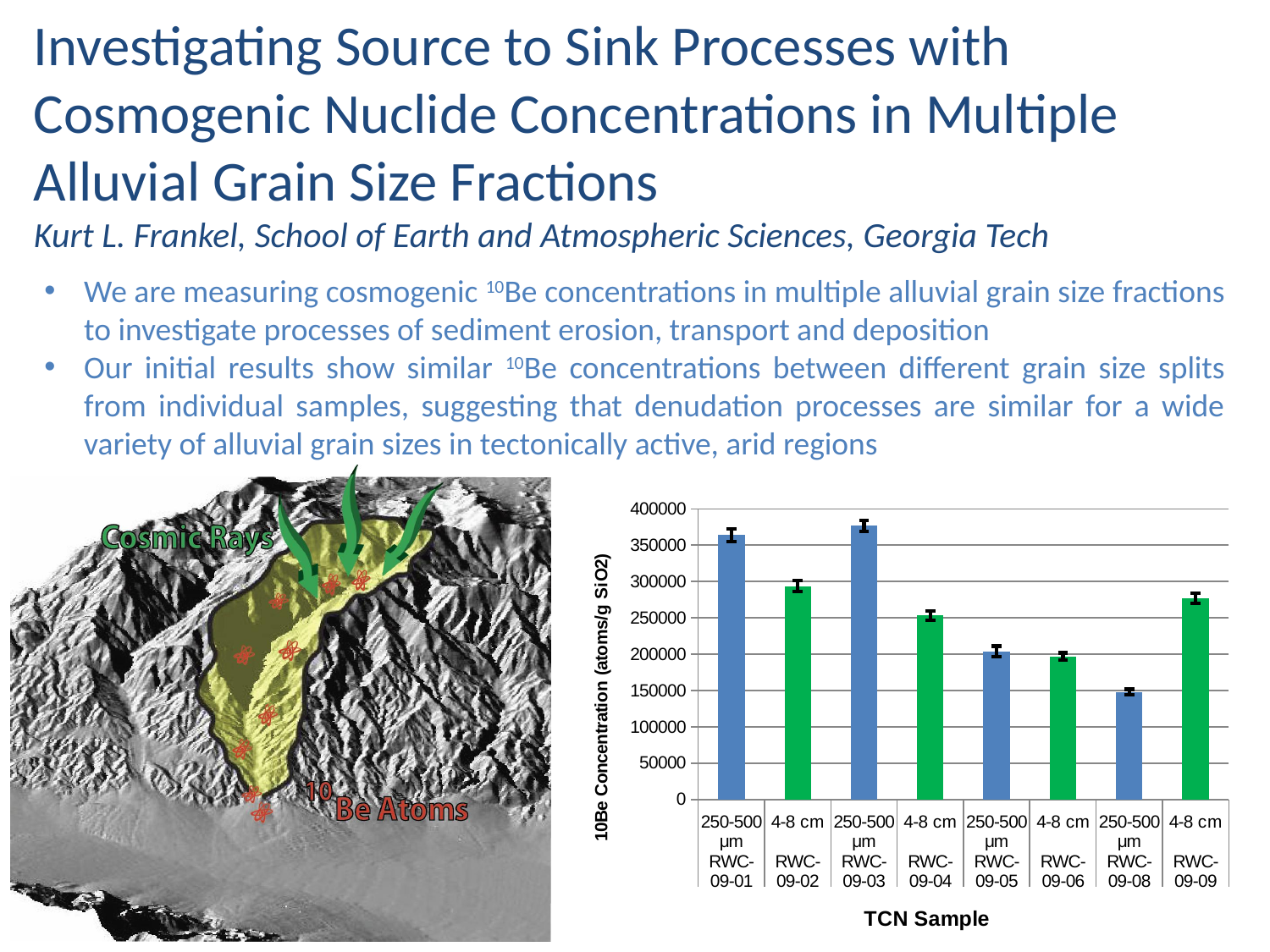
How many bars (TCN samples) are plotted in the chart? 8 Is the 10Be concentration for RWC-09-05 greater or less than 250000? less Is the 10Be concentration for RWC-09-09 greater or less than 250000? greater Which TCN sample has the lowest 10Be concentration? RWC-09-08 What kind of chart is shown on the slide? bar chart What is the title of the chart's vertical axis? 10Be Concentration (atoms/g SiO2) Which has a higher 10Be concentration, RWC-09-01 or RWC-09-02? RWC-09-01 Which has a higher 10Be concentration, RWC-09-08 or RWC-09-09? RWC-09-09 What is the title of the chart's horizontal axis? TCN Sample Is the 10Be concentration for RWC-09-08 greater or less than 200000? less